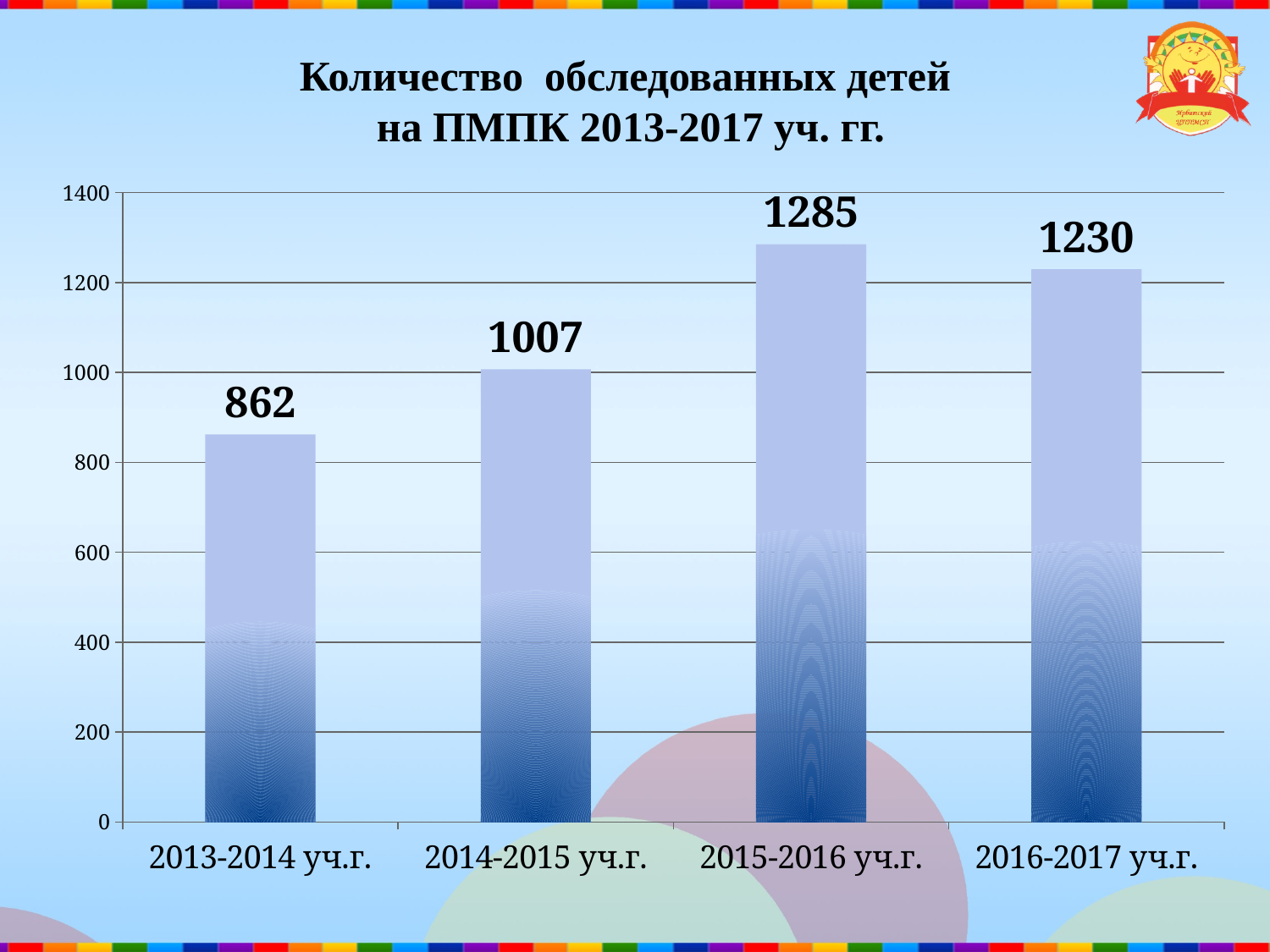
What is the title of the chart? Количество обследованных детей на ПМПК 2013-2017 уч. гг. Which academic year has the lowest value? 2013-2014 уч.г. How many academic years are shown on the chart? 4 Which is larger, the value for 2014-2015 уч.г. or the value for 2016-2017 уч.г.? 2016-2017 уч.г. What is the difference between the values for 2014-2015 уч.г. and 2013-2014 уч.г.? 145 What is the value for 2013-2014 уч.г.? 862 What is the value for 2016-2017 уч.г.? 1230 What is the difference between the values for 2015-2016 уч.г. and 2016-2017 уч.г.? 55 What is the value for 2015-2016 уч.г.? 1285 What kind of chart is shown on the slide? bar chart Is the value for 2014-2015 уч.г. greater or less than 1000? greater Which academic year has the highest value? 2015-2016 уч.г.